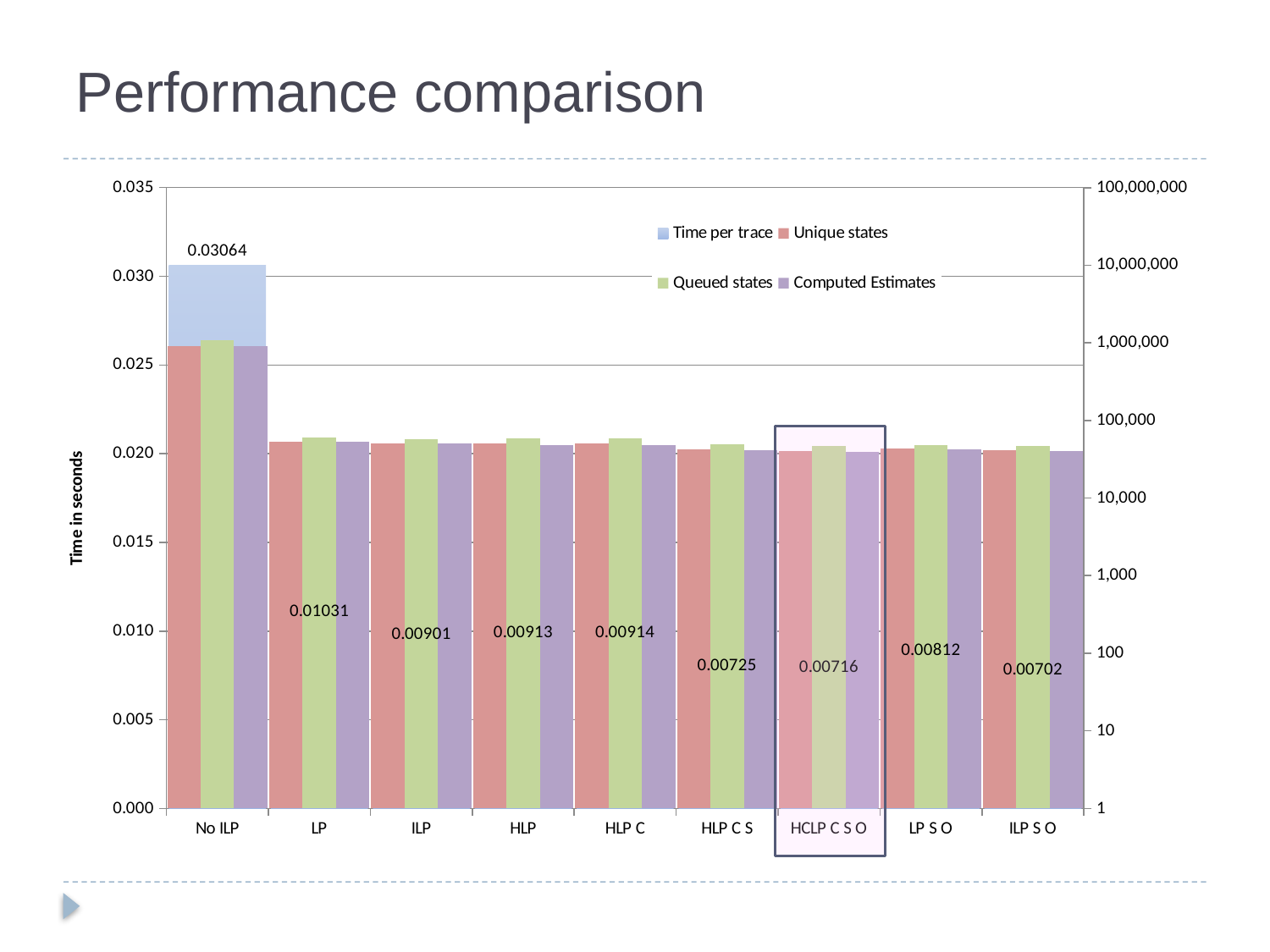
Is the Time per trace for ILP greater or less than 0.010? less What is the difference in Time per trace between No ILP and LP? 0.02033 How many categories are shown on the x axis? 9 What is the Time per trace value for No ILP? 0.03064 How many series does the legend list? 4 What is the Time per trace value for HCLP C S O? 0.00716 What is the label of the left vertical axis? Time in seconds What is the Time per trace value for LP S O? 0.00812 Which category has the lowest Time per trace? ILP S O Which has a larger Time per trace, HLP C S or LP S O? LP S O Which category has the highest Time per trace? No ILP What kind of chart is shown on the slide? bar chart